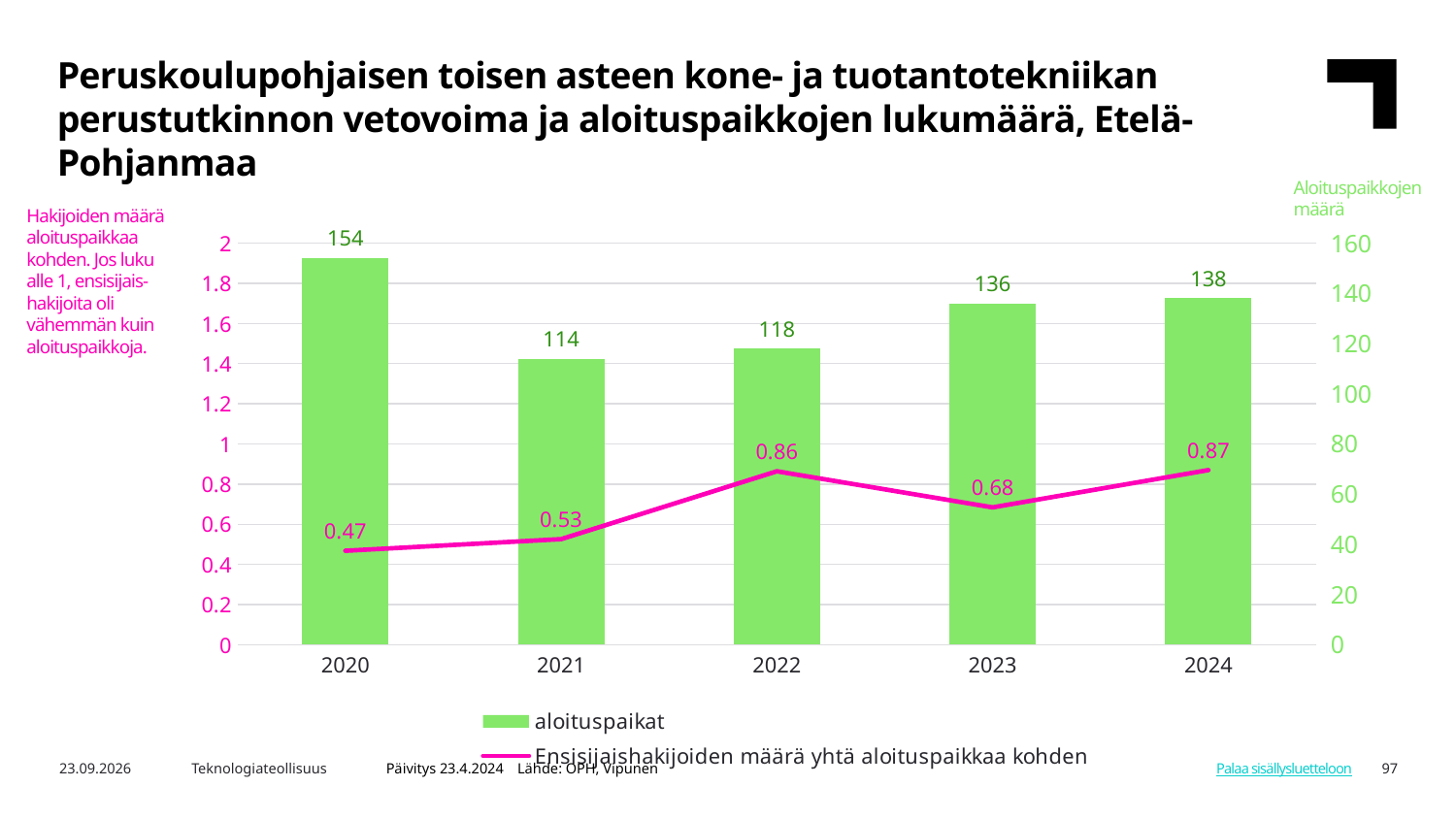
How many years are shown on the x axis? 5 What colour is the line for Ensisijaishakijoiden määrä yhtä aloituspaikkaa kohden? pink What is the difference in aloituspaikat between 2020 and 2021? 40 Which year has the lowest value for Ensisijaishakijoiden määrä yhtä aloituspaikkaa kohden? 2020 How many series does the legend list? 2 Which year has the highest value for aloituspaikat? 2020 What is the value of Ensisijaishakijoiden määrä yhtä aloituspaikkaa kohden for 2023? 0.68 What is the value of aloituspaikat for 2020? 154 Is the value of aloituspaikat for 2022 greater or less than 100? greater What is the value of aloituspaikat for 2024? 138 Which year has a higher value for Ensisijaishakijoiden määrä yhtä aloituspaikkaa kohden, 2022 or 2023? 2022 What kind of chart is used for the aloituspaikat series? bar chart